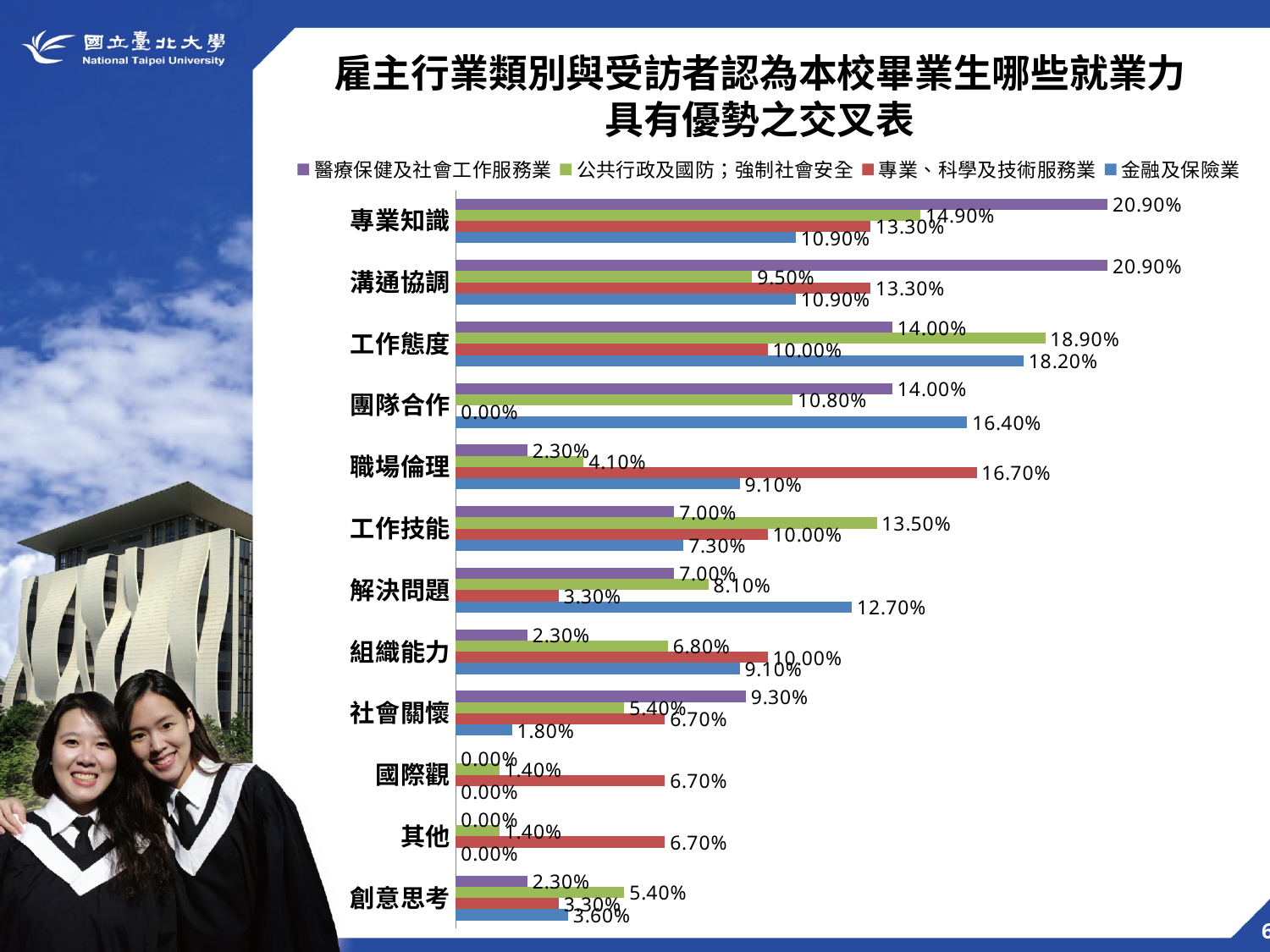
In the 工作技能 category, which is larger: the value for 公共行政及國防；強制社會安全 or the value for 專業、科學及技術服務業? 公共行政及國防；強制社會安全 What is the value for 醫療保健及社會工作服務業 in the 專業知識 category? 20.90% What is the value for 專業、科學及技術服務業 in the 職場倫理 category? 16.70% What is the difference between the 醫療保健及社會工作服務業 value and the 金融及保險業 value in the 溝通協調 category? 10.00% How many categories are shown on the vertical axis of the chart? 12 What is the value for 公共行政及國防；強制社會安全 in the 工作態度 category? 18.90% Which series has the lowest value in the 社會關懷 category? 金融及保險業 What type of chart is shown on the slide? Bar chart Which series has the highest value in the 解決問題 category? 金融及保險業 What is the value for 金融及保險業 in the 團隊合作 category? 16.40% How many series does the legend list? 4 Which colour represents 專業、科學及技術服務業 in the chart? Red